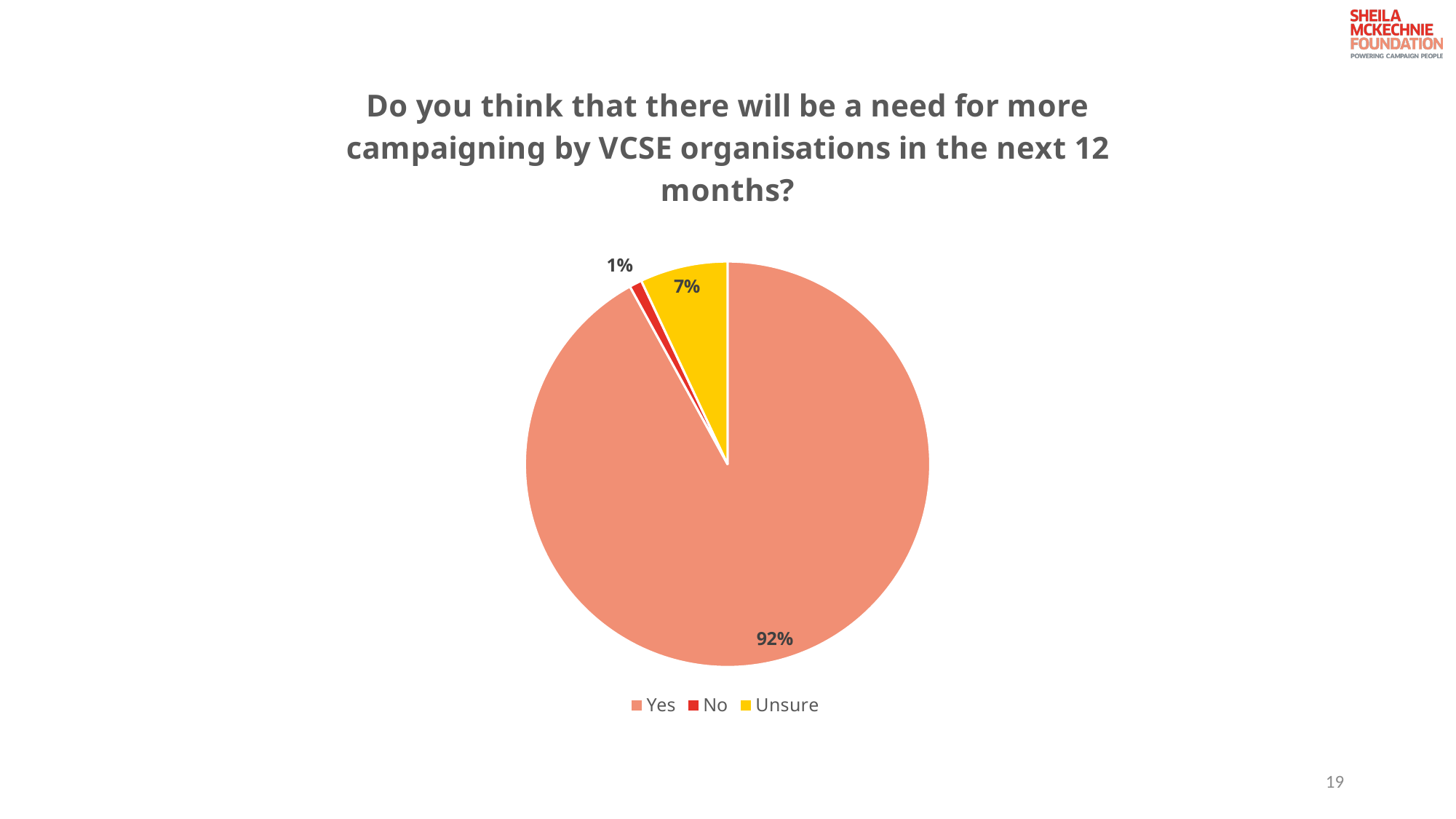
What percentage of respondents answered No? 1% What kind of chart is shown on the slide? Pie chart How many slices does the pie chart have? 3 What is the difference in percentage points between the Unsure and No slices? 6 What percentage of respondents answered Yes? 92% What is the difference in percentage points between the Yes and Unsure slices? 85 What colour is the Unsure slice? Yellow What is the combined share of the No and Unsure slices? 8% Which is larger, the Unsure slice or the No slice? Unsure Which response has the smallest share of the pie? No What percentage of respondents answered Unsure? 7% Which response has the largest share of the pie? Yes